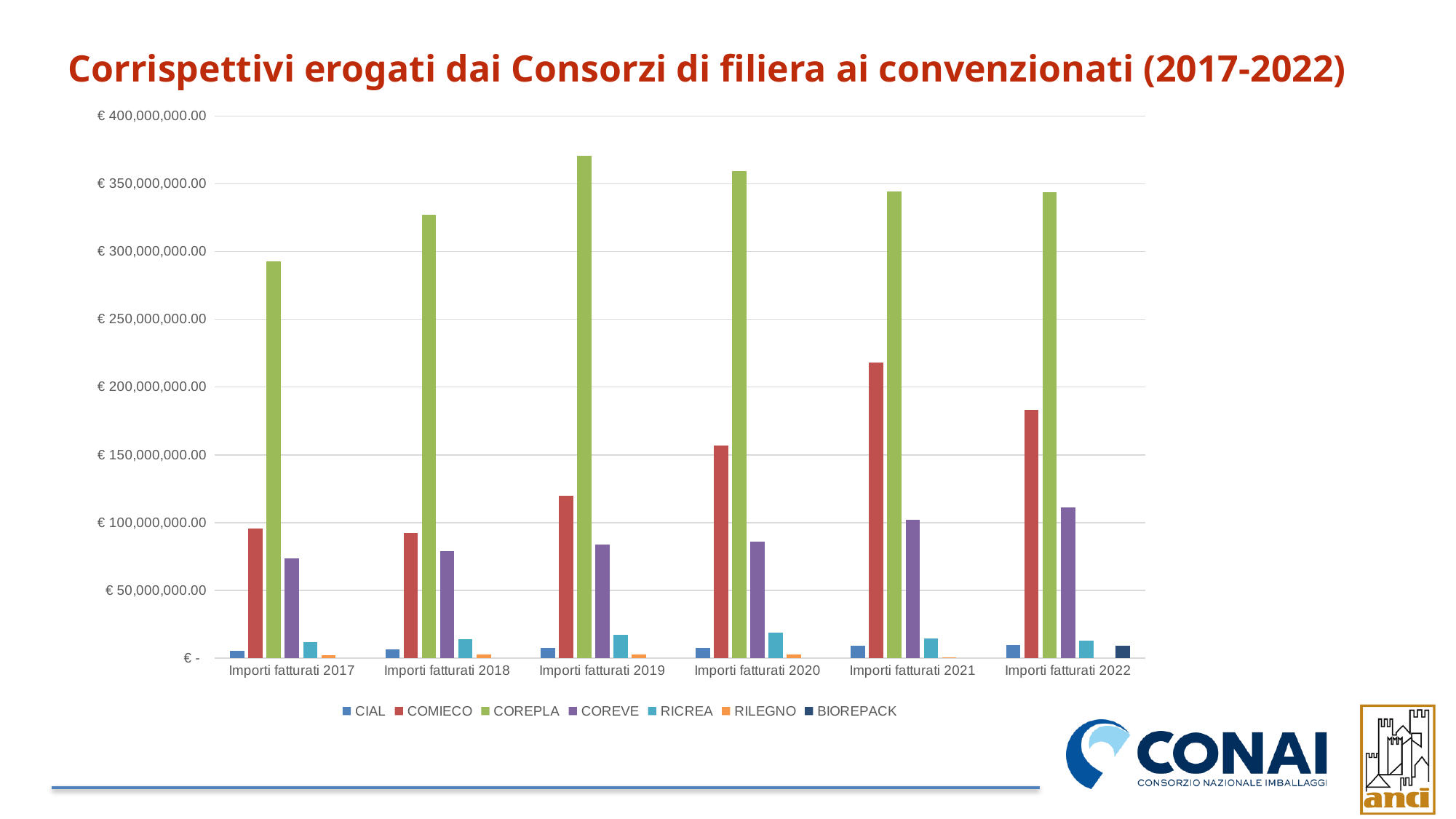
Is the value for COREPLA in Importi fatturati 2017 greater or less than € 300,000,000.00? less How many series does the legend list? 7 Which is larger: COMIECO in Importi fatturati 2021 or COMIECO in Importi fatturati 2022? Importi fatturati 2021 Do the values for COREVE rise or fall from Importi fatturati 2017 to Importi fatturati 2022? rise What kind of chart is shown on the slide? bar chart Is the value for COREVE in Importi fatturati 2022 greater or less than € 100,000,000.00? greater In which year category does COMIECO reach its highest value? Importi fatturati 2021 How many year categories are shown on the x axis? 6 Is the value for COREPLA in Importi fatturati 2019 greater or less than € 350,000,000.00? greater Which series appears only in the Importi fatturati 2022 category? BIOREPACK Which consortium has the highest value in Importi fatturati 2019? COREPLA